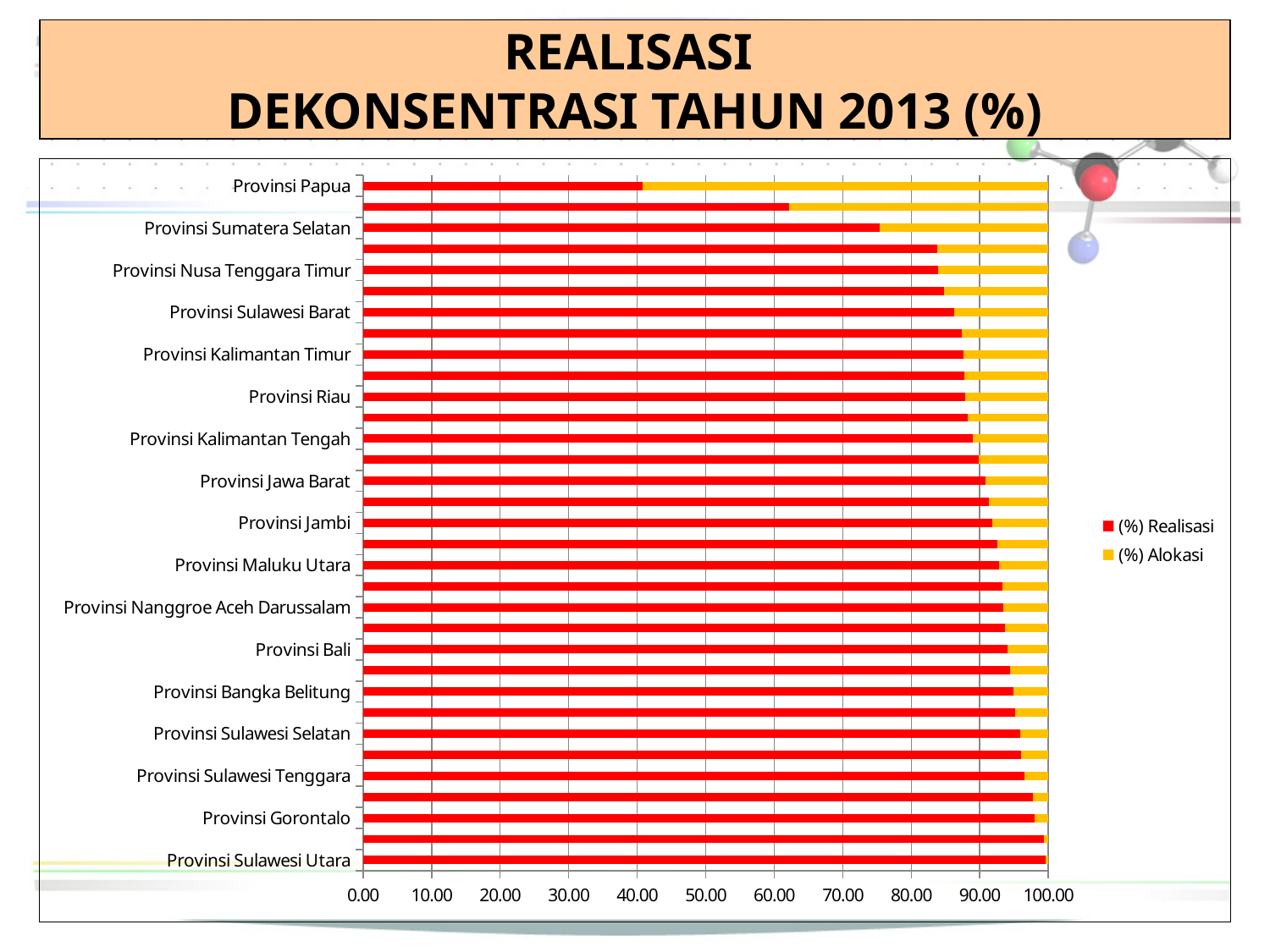
Which has the larger (%) Realisasi value, Provinsi Papua or Provinsi Sumatera Selatan? Provinsi Sumatera Selatan Is the (%) Realisasi value for Provinsi Sulawesi Utara greater or less than 90.00? greater Is the (%) Realisasi value for Provinsi Nusa Tenggara Timur greater or less than 90.00? less What are the two series named in the legend? (%) Realisasi and (%) Alokasi Is the (%) Realisasi value for Provinsi Papua greater or less than 50.00? less What kind of chart is shown on the slide? bar chart Do the red (%) Realisasi bars get longer or shorter going from the top of the chart (Provinsi Papua) to the bottom (Provinsi Sulawesi Utara)? longer How many series does the legend list? 2 Which labelled province has the lowest (%) Realisasi value? Provinsi Papua Which colour represents (%) Realisasi in the chart? red